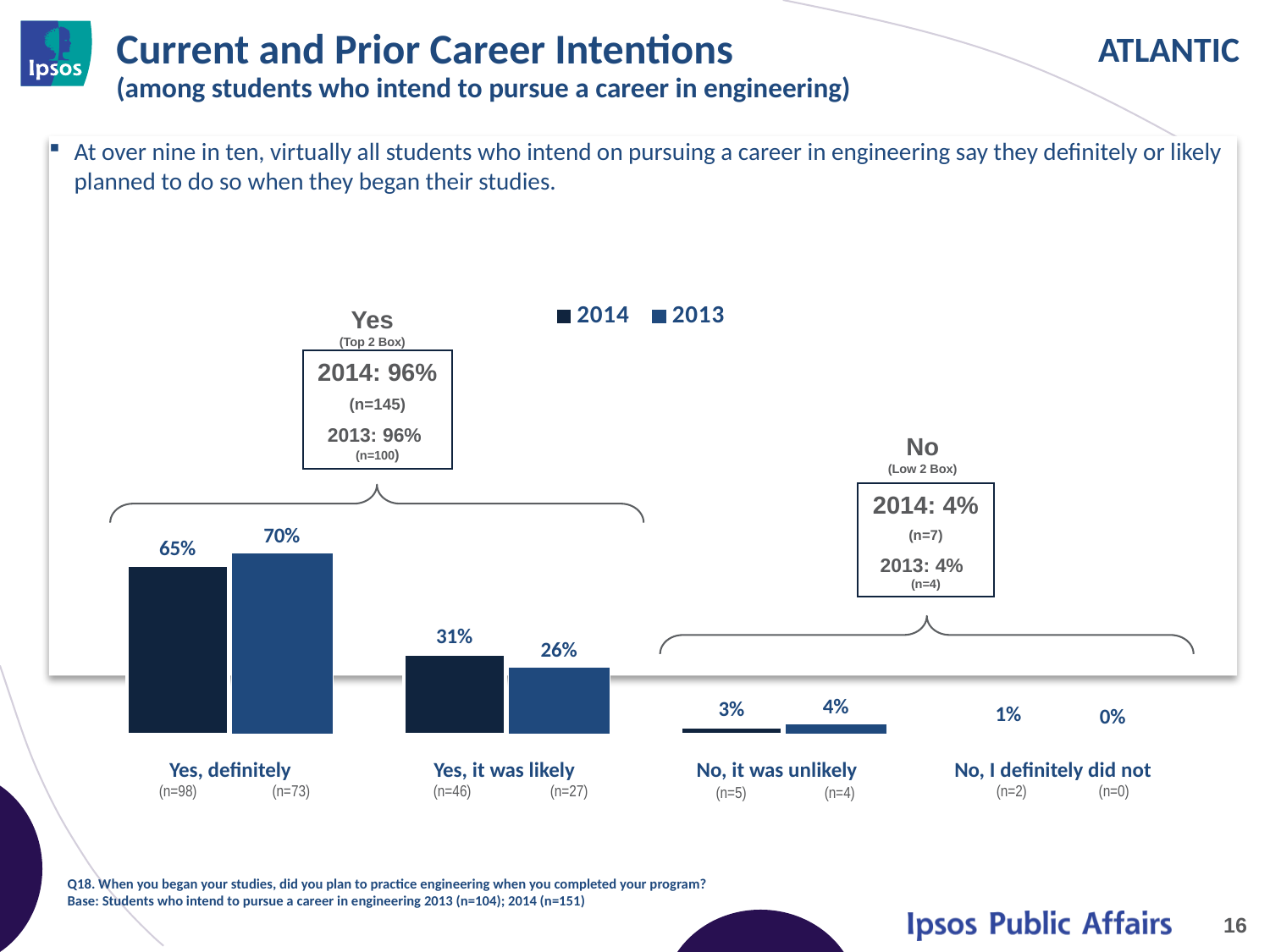
Which category has the highest 2013 value? Yes, definitely Which category has the lowest 2014 value? No, I definitely did not How many categories are shown on the x axis? 4 What kind of chart is shown on the slide? Bar chart What is the 2014 "Yes (Top 2 Box)" total shown in the callout? 96% What is the 2013 value for "Yes, it was likely"? 26% What is the 2014 value for "No, I definitely did not"? 1% What is the 2014 value for "Yes, definitely"? 65% How many series does the legend list? 2 What is the 2013 value for "No, it was unlikely"? 4% What is the difference between the 2013 and 2014 values for "Yes, definitely"? 5% Which is larger for "Yes, it was likely": the 2014 value or the 2013 value? 2014